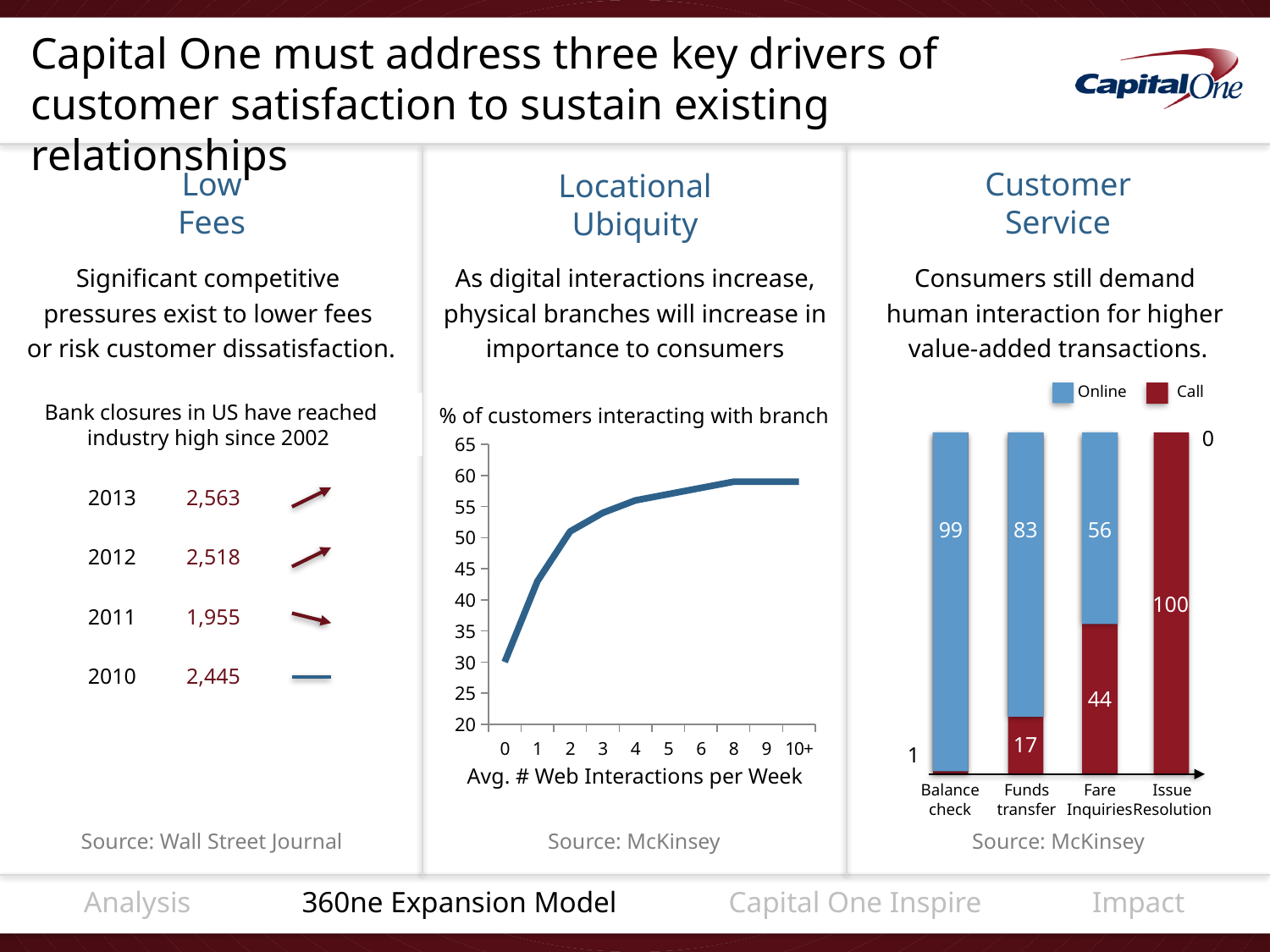
In the middle chart, is the value at 0 web interactions per week greater or less than 40? less In the right-hand chart, what is the difference between the Online and Call values for Funds transfer? 66 In the right-hand chart, what is the Online value for Funds transfer? 83 In the middle chart, does the % of customers interacting with branch rise or fall as the average number of web interactions per week increases? rise In the right-hand chart, how many categories are shown on the x axis? 4 In the right-hand chart, what is the Call value for Issue Resolution? 100 In the right-hand chart, which category has the highest Online value? Balance check What kind of chart is the right-hand chart with the Online and Call legend? bar chart In the right-hand chart, how many series does the legend list? 2 In the right-hand chart, what is the Call value for Fare Inquiries? 44 In the right-hand chart, for Fare Inquiries, which is larger: the Online value or the Call value? Online What kind of chart is the middle chart titled "% of customers interacting with branch"? line chart